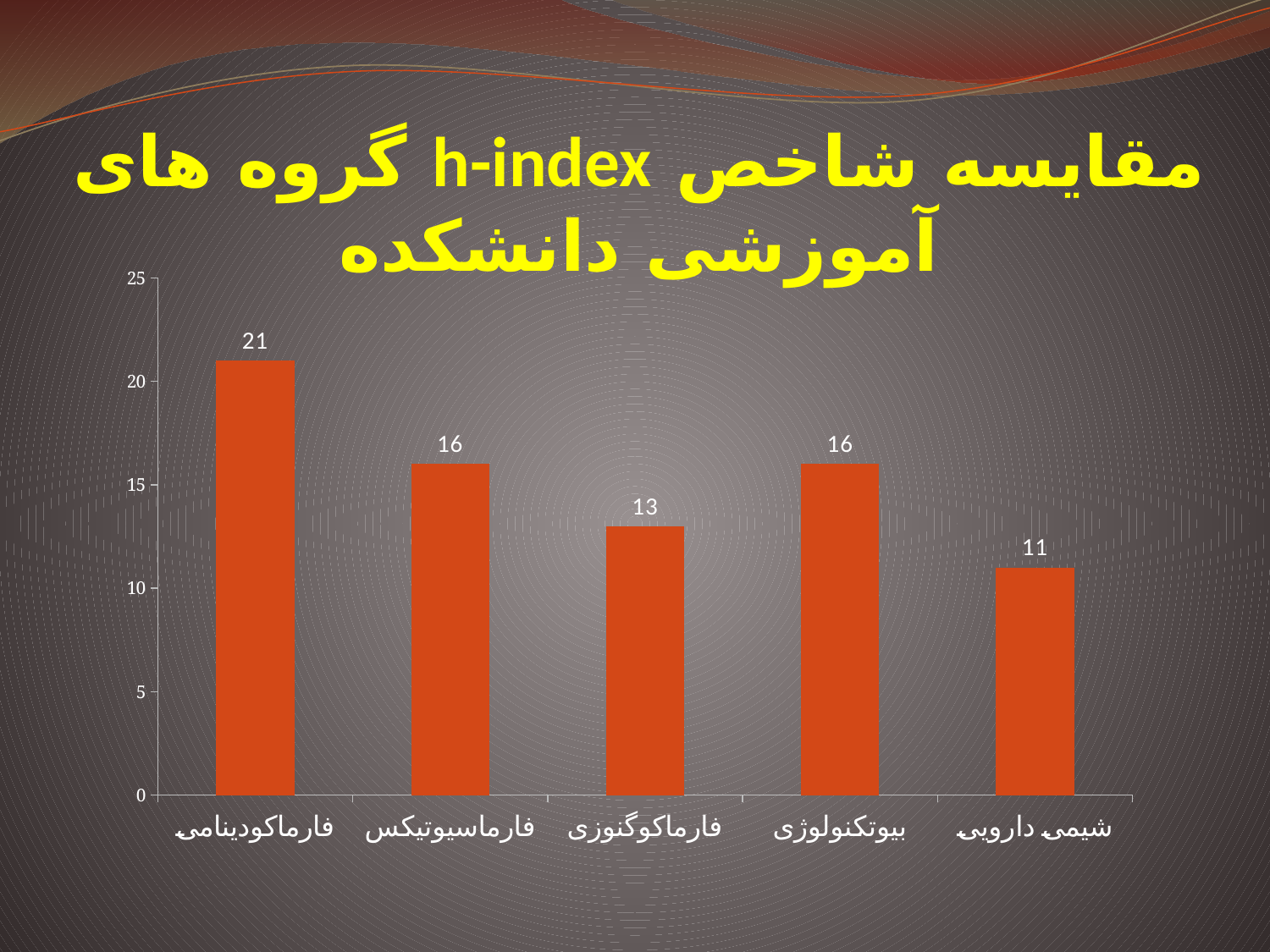
Which group has the lowest h-index on the chart? شیمی دارویی Which group has the highest h-index on the chart? فارماکودینامی What kind of chart is shown on the slide? Bar chart What is the maximum value shown on the vertical axis of the chart? 25 What is the h-index value shown for فارماکودینامی? 21 What is the h-index value shown for بیوتکنولوژی? 16 What is the h-index value shown for فارماکوگنوزی? 13 How many groups are shown on the chart? 5 What is the difference between the h-index of فارماسیوتیکس and فارماکوگنوزی? 3 What is the difference between the h-index of فارماکودینامی and شیمی دارویی? 10 What is the h-index value shown for شیمی دارویی? 11 Which has a larger h-index, فارماکوگنوزی or بیوتکنولوژی? بیوتکنولوژی